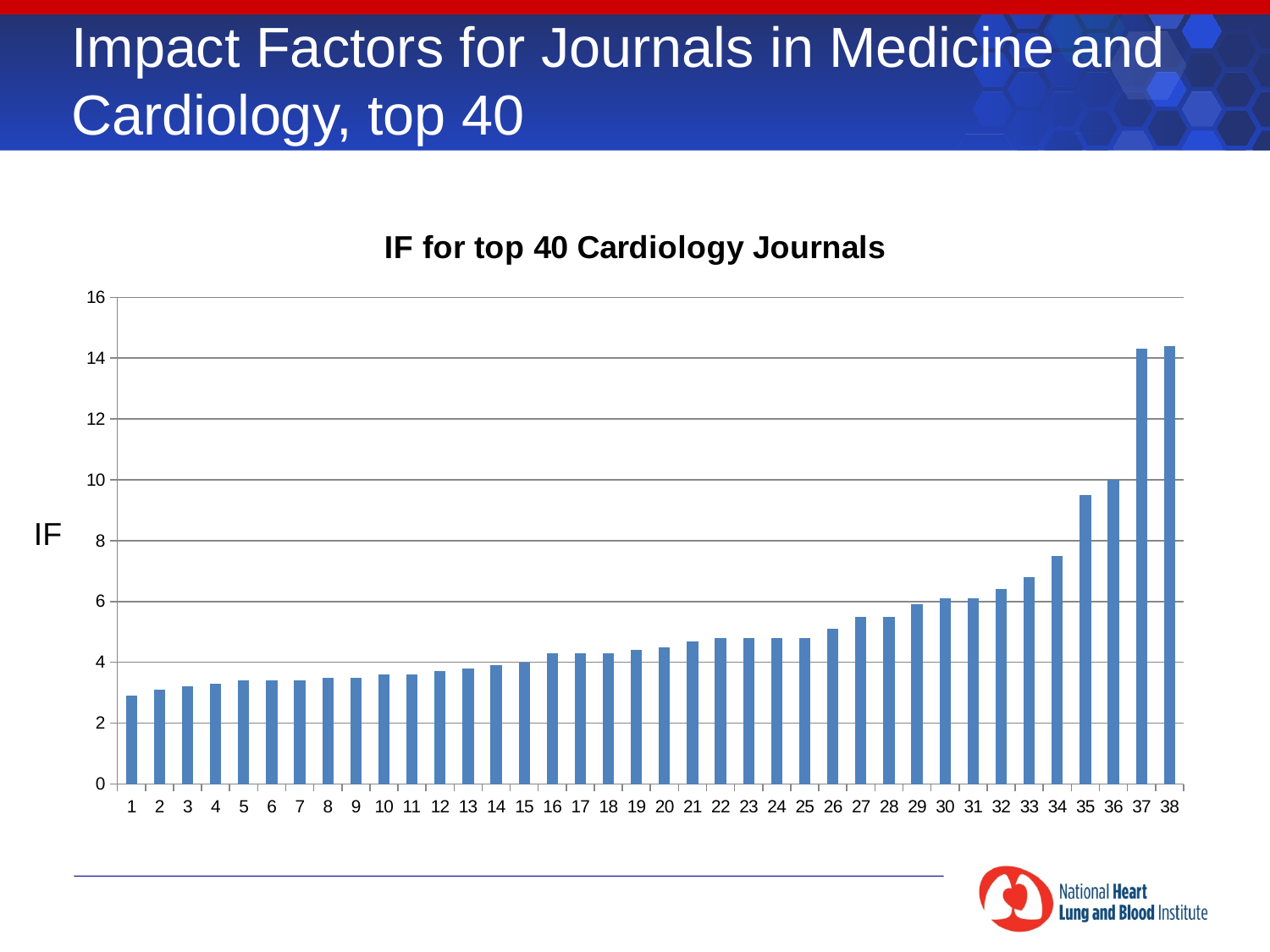
What is the title of the chart? IF for top 40 Cardiology Journals Is the value for bar 38 greater or less than 14? greater Which has the larger value, bar 5 or bar 25? bar 25 What kind of chart is shown on the slide? bar chart Is the value for bar 20 greater or less than 4? greater Is the value for bar 34 greater or less than 8? less Which has the larger value, bar 33 or bar 37? bar 37 How many bars (journals) are plotted on the chart? 38 Do the impact factor values rise or fall moving from bar 1 to bar 38 along the x axis? rise